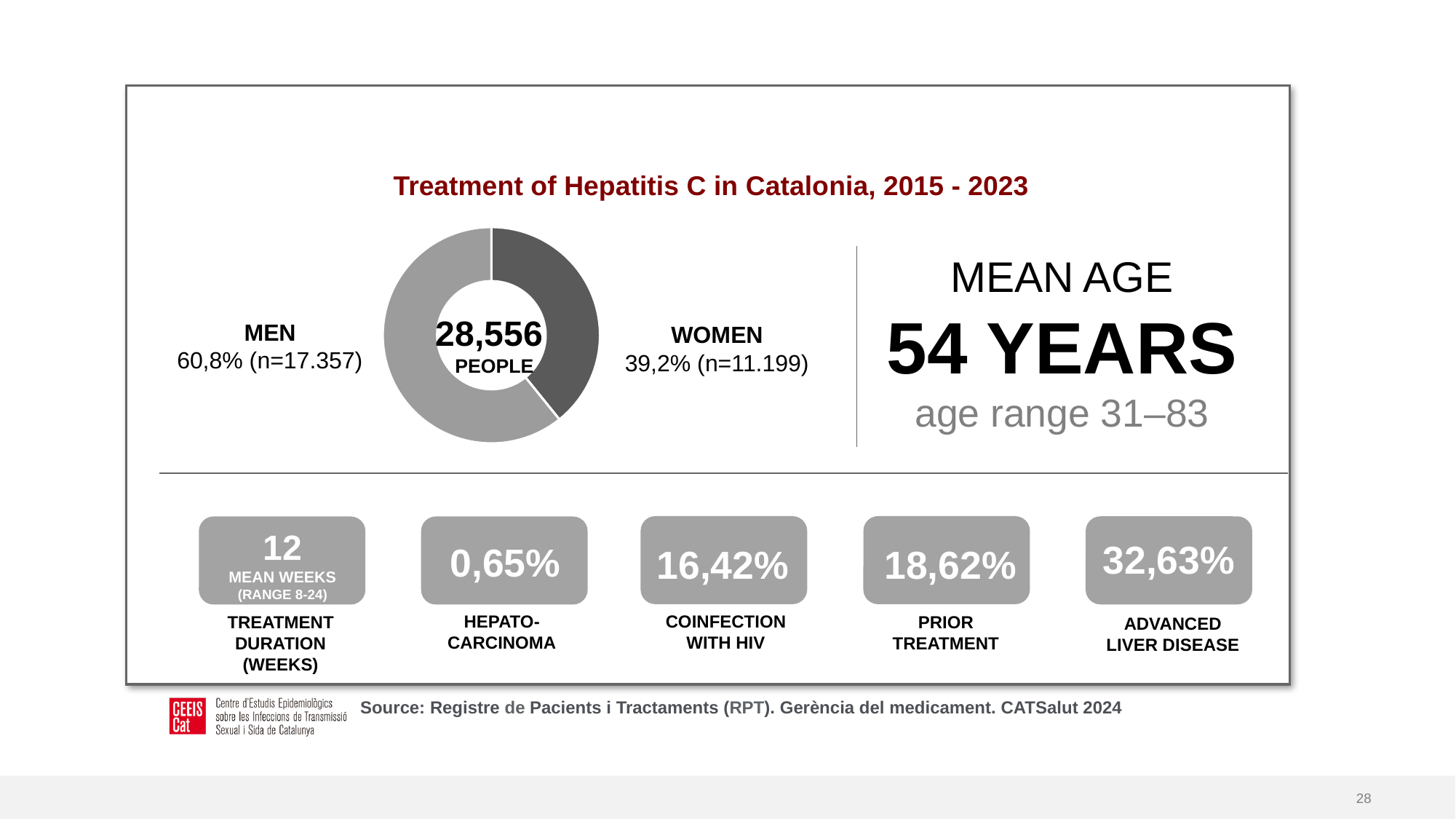
What percentage of the donut chart is men? 60,8% How many categories does the donut chart show? 2 What type of chart is shown on the slide? Donut chart What total number of people is shown in the centre of the donut chart? 28,556 How many men are represented in the donut chart? 17.357 How many women are represented in the donut chart? 11.199 Which category has the smallest share of the donut chart? Women Is the share for women in the donut chart greater or less than 50%? less What is the title of the chart? Treatment of Hepatitis C in Catalonia, 2015 - 2023 What is the difference in percentage points between the men and women shares in the donut chart? 21,6 Which group has the larger share of the donut chart, men or women? Men What percentage of the donut chart is women? 39,2%